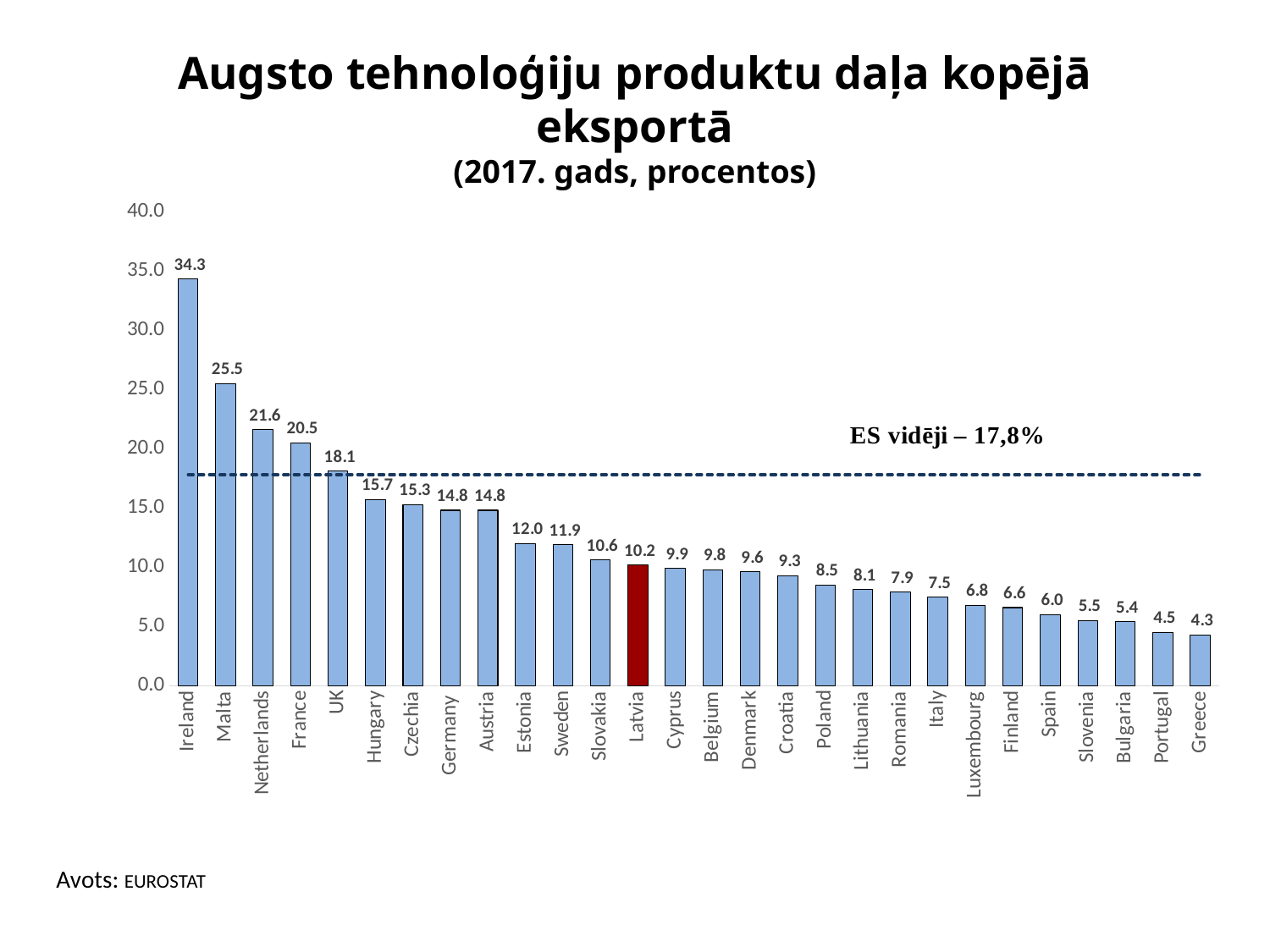
What kind of chart is shown on the slide? bar chart Which country has the highest value? Ireland Do the values rise or fall from left to right along the x axis? fall How many countries are shown on the chart? 28 Is the value for Hungary greater or less than 20.0? less What is the difference between the values for Malta and Netherlands? 3.9 What is the value for Latvia? 10.2 What is the value for Finland? 6.6 What EU average value is indicated by the dashed line on the chart? 17,8% What is the value for Ireland? 34.3 Which country has the lowest value? Greece Which is larger, the value for Estonia or the value for Slovakia? Estonia